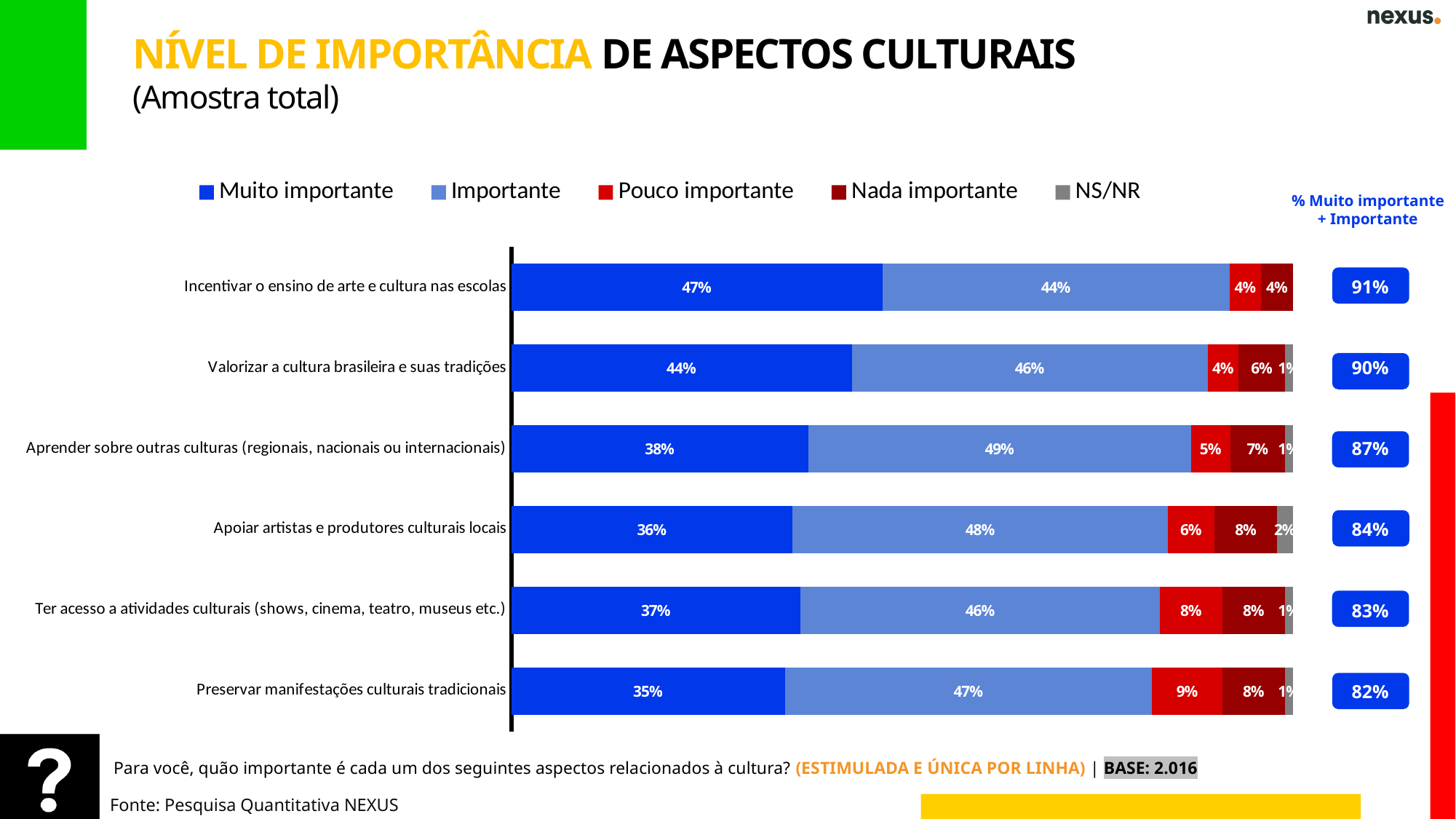
What percentage of respondents rated "Incentivar o ensino de arte e cultura nas escolas" as "Muito importante"? 47% What is the "Importante" value for "Aprender sobre outras culturas (regionais, nacionais ou internacionais)"? 49% How many categories (aspects) are shown in the chart? 6 Which category has the lowest "Muito importante" value? Preservar manifestações culturais tradicionais What is the "Pouco importante" value for "Preservar manifestações culturais tradicionais"? 9% How many series does the legend list? 5 What kind of chart is shown on the slide? Stacked bar chart Which is larger: the "Importante" value for "Valorizar a cultura brasileira e suas tradições" or for "Apoiar artistas e produtores culturais locais"? Apoiar artistas e produtores culturais locais What is the difference between the "Muito importante" values for "Incentivar o ensino de arte e cultura nas escolas" and "Preservar manifestações culturais tradicionais"? 12% What is the "NS/NR" value for "Apoiar artistas e produtores culturais locais"? 2% Which category has the highest "Muito importante" value? Incentivar o ensino de arte e cultura nas escolas What is the combined "% Muito importante + Importante" shown for "Ter acesso a atividades culturais (shows, cinema, teatro, museus etc.)"? 83%